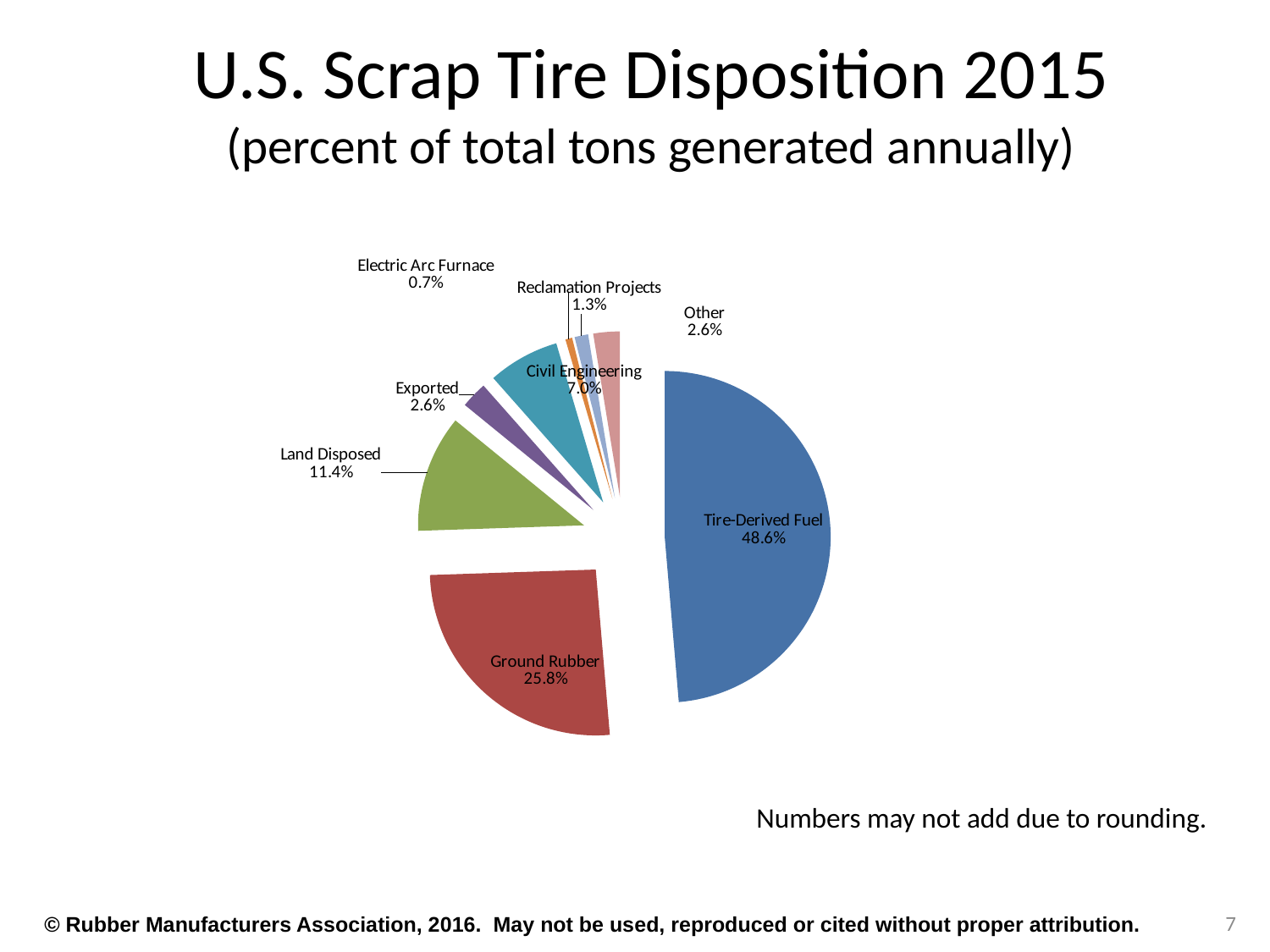
What kind of chart is shown on the slide? pie chart Which is larger, the share for Land Disposed or the share for Civil Engineering? Land Disposed Which category has the largest share of the pie? Tire-Derived Fuel How many categories (slices) are shown in the pie chart? 8 What share of scrap tires went to Tire-Derived Fuel? 48.6% What is the difference in percentage points between Tire-Derived Fuel and Ground Rubber? 22.8 What percentage is shown for Ground Rubber? 25.8% What is the title of the chart on the slide? U.S. Scrap Tire Disposition 2015 Which category has the smallest share of the pie? Electric Arc Furnace What percentage is shown for Electric Arc Furnace? 0.7% What percentage is shown for Civil Engineering? 7.0% What percentage is shown for Land Disposed? 11.4%